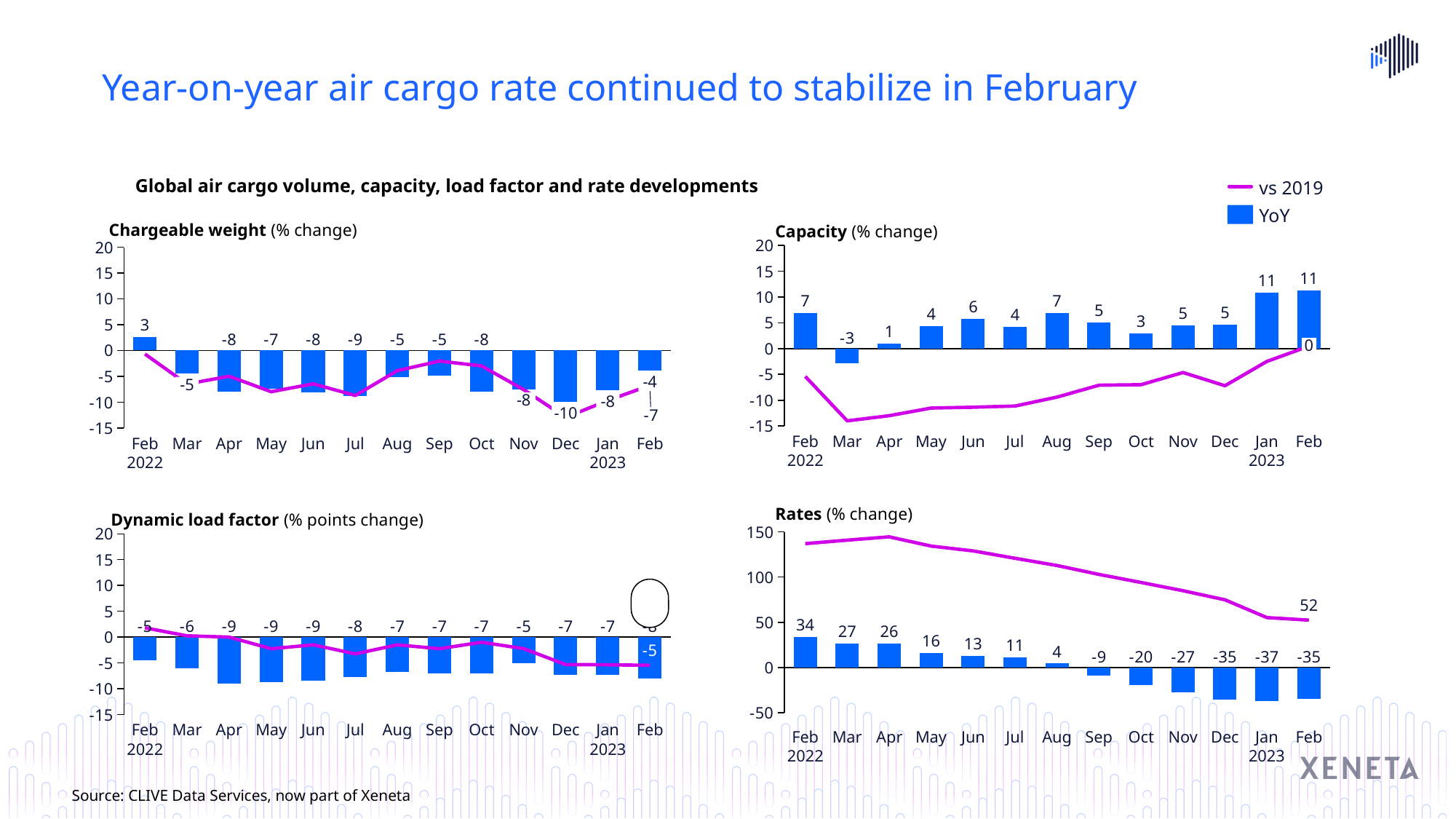
On the Chargeable weight chart, which month has the lowest YoY value? Dec On the Rates chart, does the vs 2019 line rise or fall from Feb 2022 to Feb 2023? fall On the Capacity chart, which month has the lowest YoY value? Mar How many months are shown on the x axis of the Capacity chart? 13 On the Rates chart, is the vs 2019 value for Feb 2022 greater or less than 100? greater On the Capacity chart, which is larger, the YoY value for Feb 2022 or for Oct? Feb 2022 How many series does the legend list? 2 On the Capacity chart, what is the vs 2019 value labelled for Feb 2023? 0 On the Dynamic load factor chart, what is the YoY value for Apr? -9 On the Rates chart, what is the YoY value for Feb 2023? -35 On the Rates chart, what is the difference between the YoY values for Feb 2022 and Feb 2023? 69 On the Rates chart, which month has the highest YoY value? Feb 2022